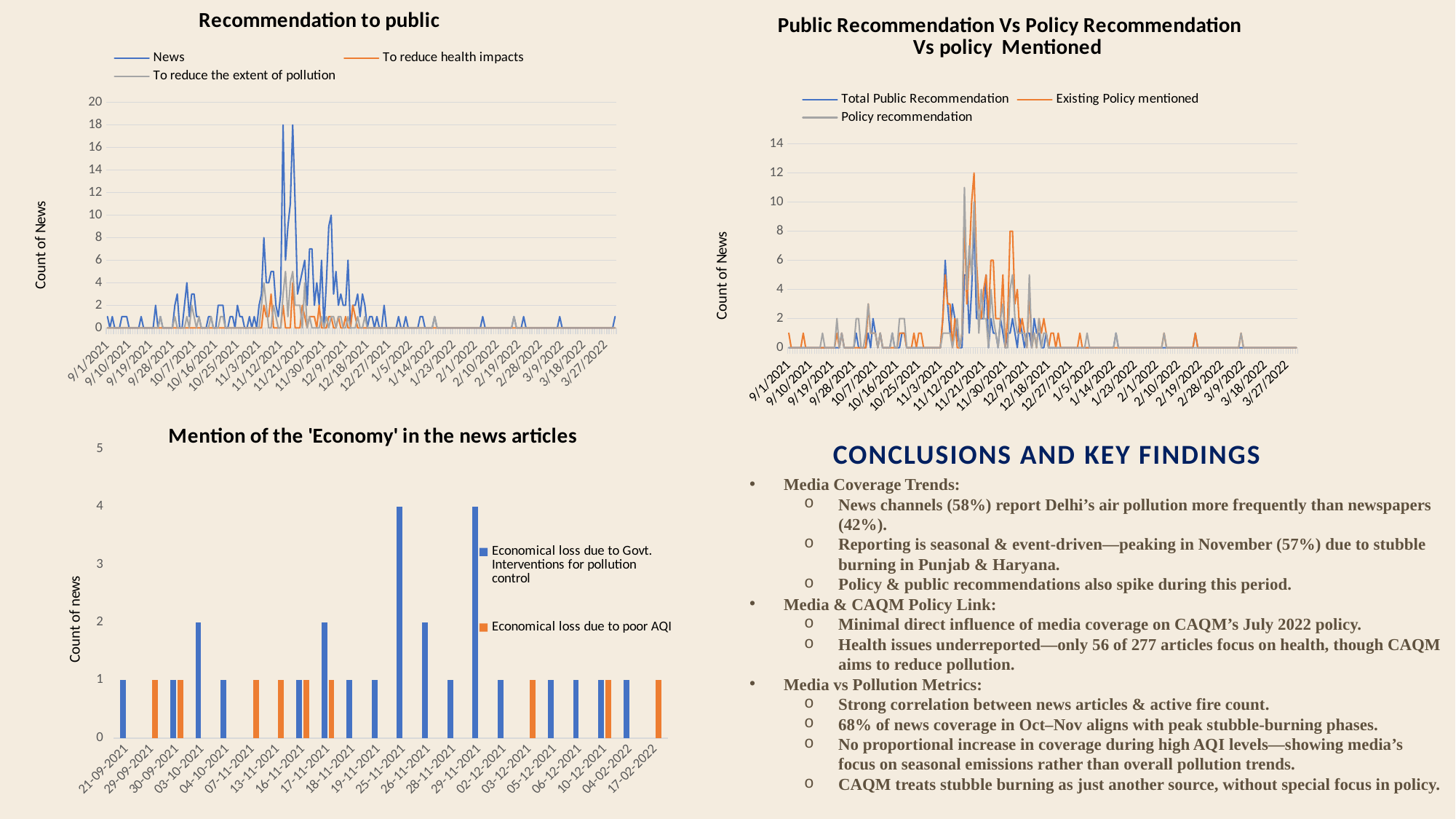
In the 'Recommendation to public' chart, which series reaches the highest peak? News In the 'Public Recommendation Vs Policy Recommendation Vs policy Mentioned' chart, is the peak of the Policy recommendation series greater or less than 10? greater How many series does the legend of the 'Recommendation to public' chart list? 3 In the 'Recommendation to public' chart, what is the highest value reached by the News series? 18 What kind of chart is the 'Mention of the 'Economy' in the news articles' chart? Bar chart What kind of chart is the 'Recommendation to public' chart? Line chart What kind of chart is the 'Public Recommendation Vs Policy Recommendation Vs policy Mentioned' chart? Line chart In the 'Public Recommendation Vs Policy Recommendation Vs policy Mentioned' chart, is the peak of the Total Public Recommendation series greater or less than 8? greater In the 'Public Recommendation Vs Policy Recommendation Vs policy Mentioned' chart, what is the highest value reached by the Existing Policy mentioned series? 12 In the 'Mention of the 'Economy' in the news articles' chart, what is the value for 'Economical loss due to Govt. Interventions for pollution control' on 25-11-2021? 4 In the 'Mention of the 'Economy' in the news articles' chart, what is the value for 'Economical loss due to Govt. Interventions for pollution control' on 03-10-2021? 2 How many series does the legend of the 'Mention of the 'Economy' in the news articles' chart list? 2